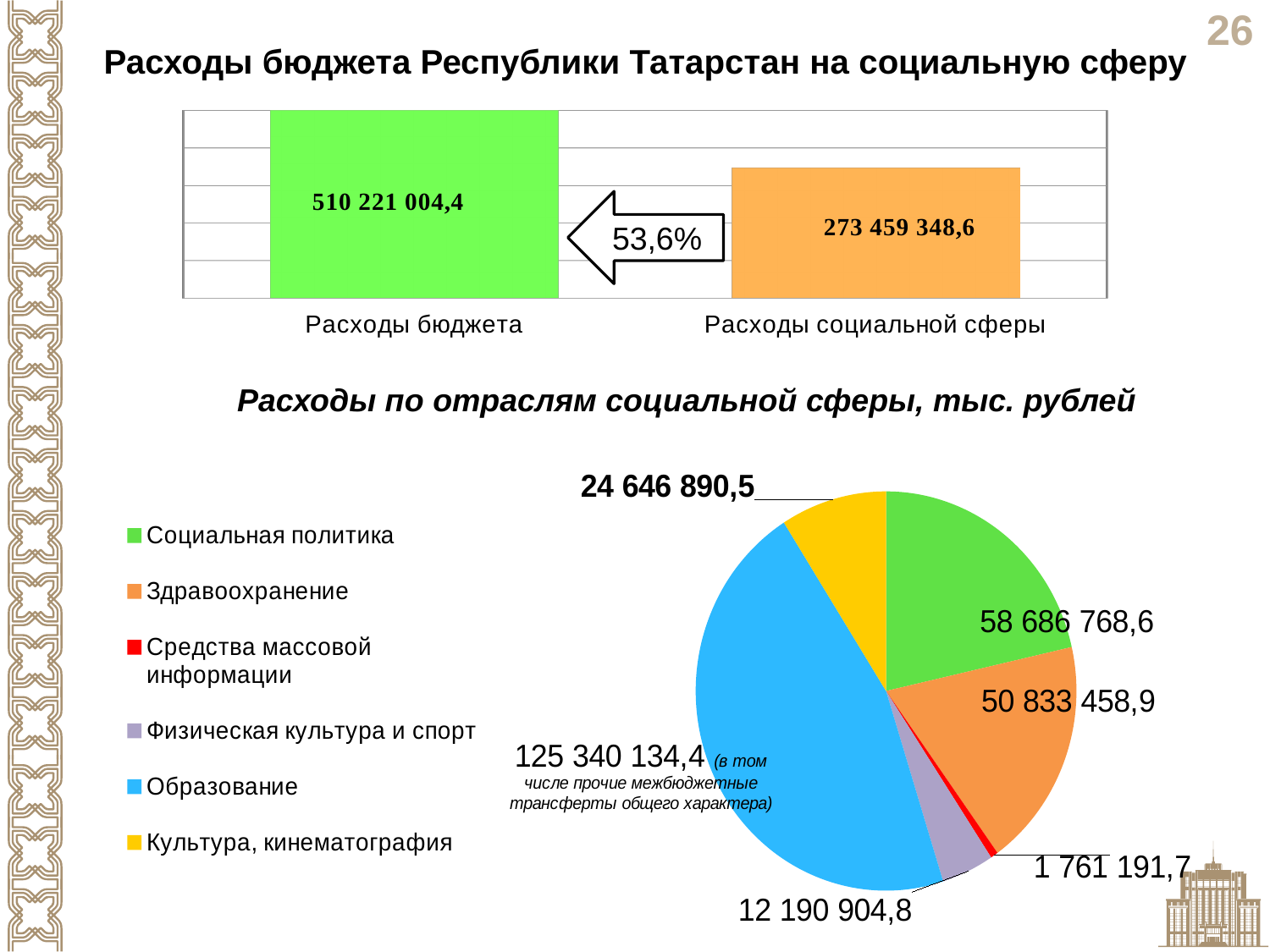
In the top bar chart, what is the value for Расходы бюджета? 510 221 004,4 In the pie chart 'Расходы по отраслям социальной сферы', what is the value for Образование? 125 340 134,4 In the pie chart 'Расходы по отраслям социальной сферы', what is the value for Культура, кинематография? 24 646 890,5 In the pie chart 'Расходы по отраслям социальной сферы', what is the value for Здравоохранение? 50 833 458,9 In the pie chart 'Расходы по отраслям социальной сферы', what is the difference between Социальная политика and Здравоохранение? 7 853 309,7 In the top bar chart, what percentage is shown in the arrow between the two bars? 53,6% In the pie chart 'Расходы по отраслям социальной сферы', which category has the smallest value? Средства массовой информации In the top bar chart, what is the difference between Расходы бюджета and Расходы социальной сферы? 236 761 655,8 In the top bar chart, what is the value for Расходы социальной сферы? 273 459 348,6 In the pie chart 'Расходы по отраслям социальной сферы', which category has the largest value? Образование How many categories does the legend of the pie chart 'Расходы по отраслям социальной сферы' list? 6 What kind of chart is the top chart on the slide? Bar chart